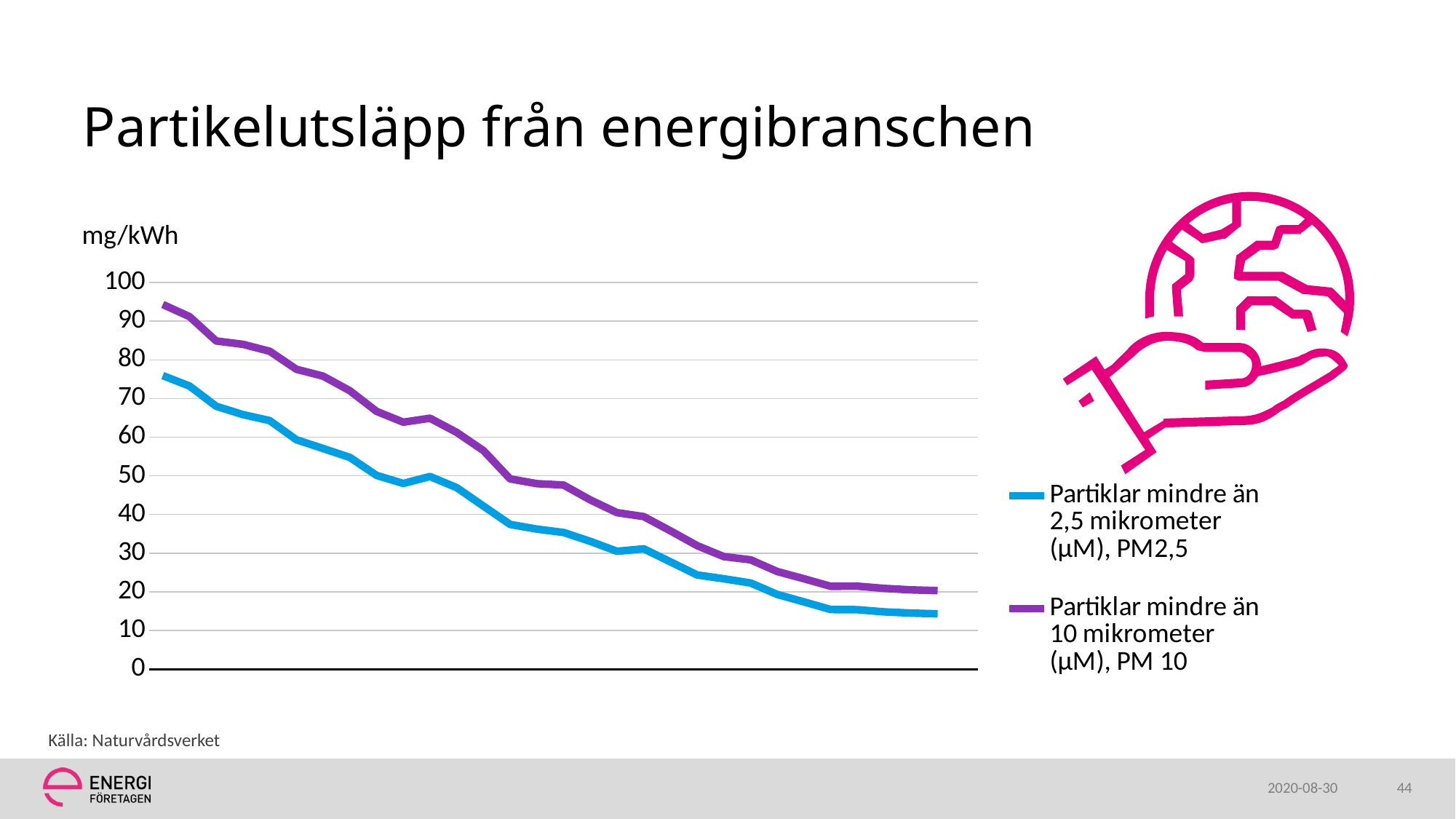
Is the first value of the PM2,5 series greater or less than 80? less Is the last value of the PM2,5 series greater or less than 20? less Do the values for the PM 10 series rise or fall along the x axis? fall How many series does the legend list? 2 Which series has the higher values throughout the chart, PM2,5 or PM 10? PM 10 What kind of chart is shown on the slide? line chart Is the last value of the PM 10 series greater or less than 30? less What unit is shown on the vertical axis of the chart? mg/kWh What is the title of the chart? Partikelutsläpp från energibranschen Do the values for the PM2,5 series rise or fall along the x axis? fall